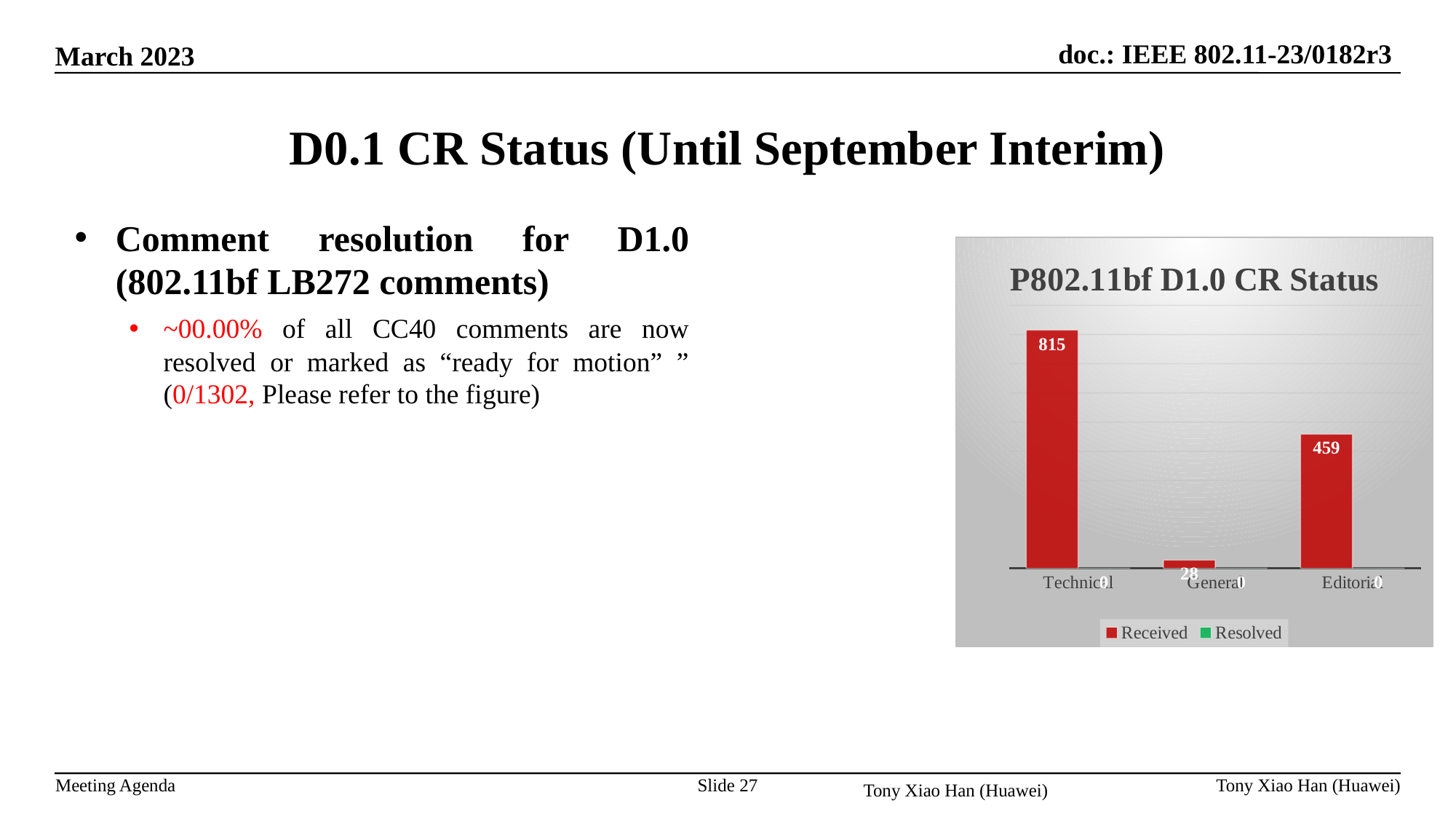
How many categories are shown on the x axis of the chart? 3 What is the Received value for General? 28 Which category has the lowest Received value? General What type of chart is shown on the slide? bar chart What is the title of the chart? P802.11bf D1.0 CR Status Which has a larger Received value, General or Editorial? Editorial How many series does the chart legend list? 2 Which category has the highest Received value? Technical What colour are the Received bars in the chart? red What is the Received value for Technical? 815 What is the Received value for Editorial? 459 What is the difference between the Received values for Technical and Editorial? 356